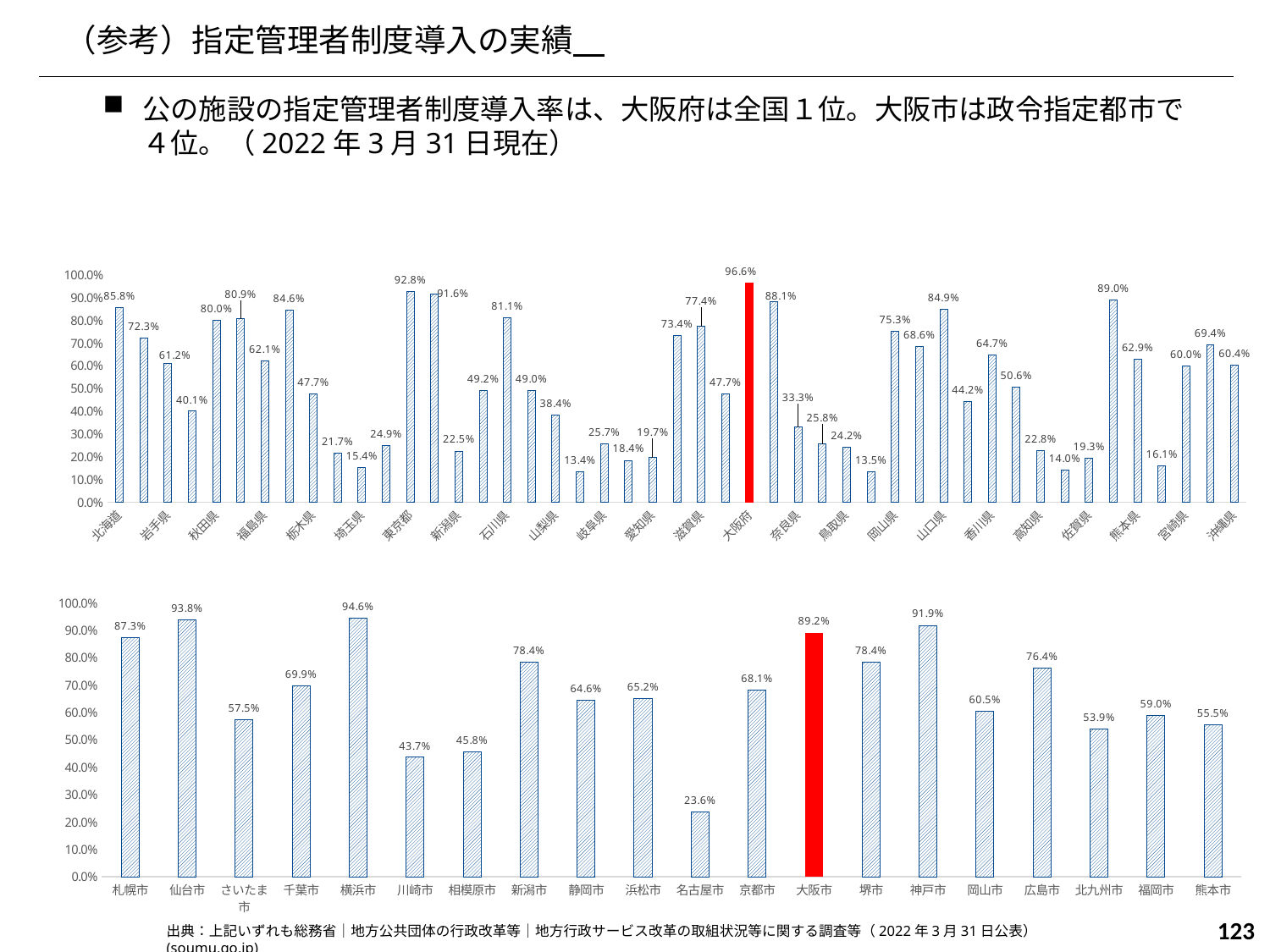
What kind of chart is the bottom chart? bar chart In the top chart, what is the value for 大阪府? 96.6% In the bottom chart, what is the value for 神戸市? 91.9% In the bottom chart, how many cities are plotted? 20 In the bottom chart, which is larger, the value for 広島市 or the value for 岡山市? 広島市 In the bottom chart, which city has the lowest value? 名古屋市 In the bottom chart, is the value for 川崎市 greater or less than 50.0%? less In the bottom chart, what is the difference between the values for 仙台市 and 札幌市? 6.5% In the bottom chart, which city has the highest value? 横浜市 In the bottom chart, what is the value for 大阪市? 89.2% In the top chart, which prefecture has the highest value? 大阪府 In the top chart, what is the value for 東京都? 92.8%